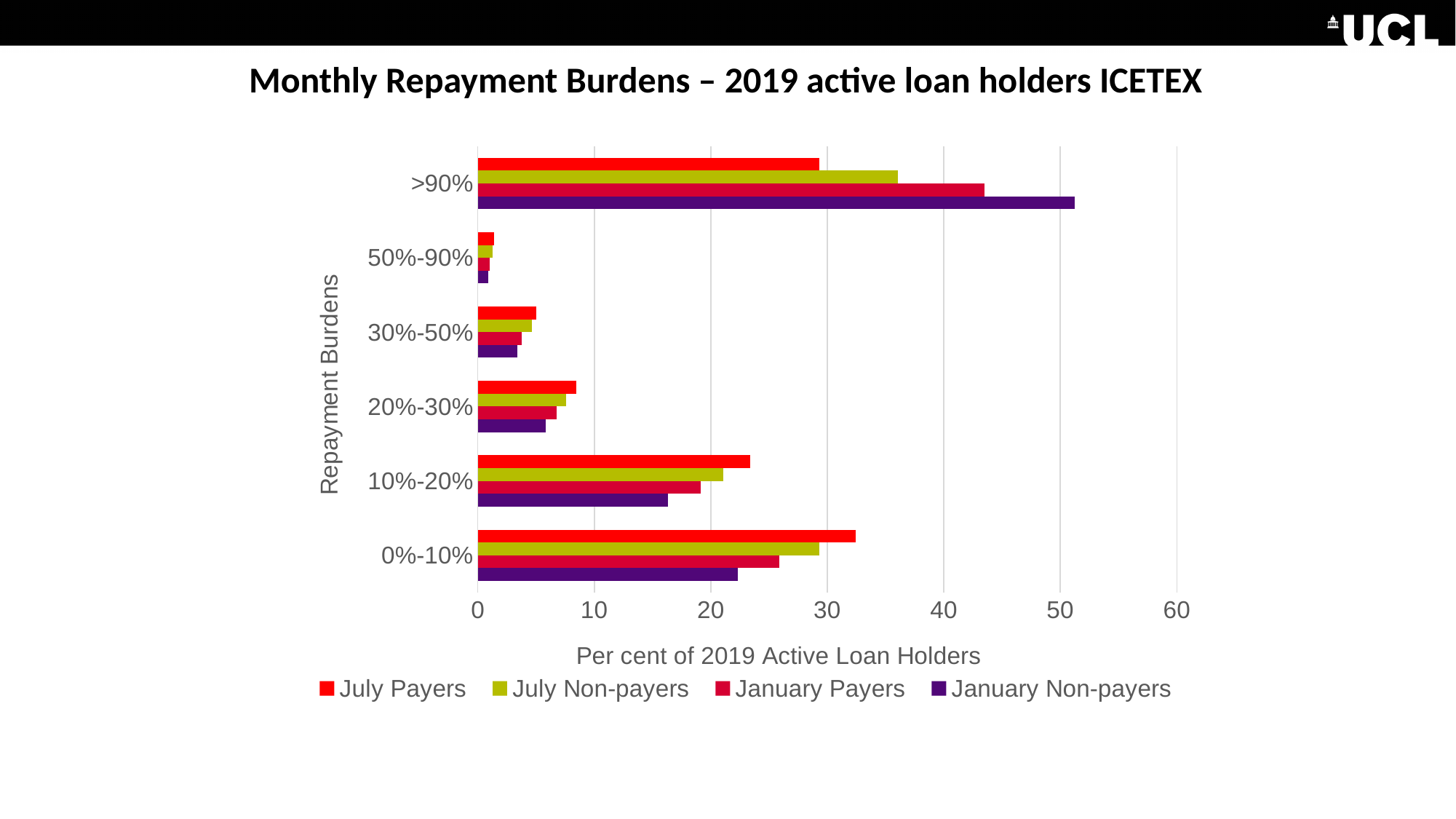
Which repayment burden category has the highest value for January Non-payers? >90% How many repayment burden categories are shown on the y axis? 6 What kind of chart is shown on the slide? Bar chart Is the value for July Payers in the 0%-10% category greater or less than 30? greater What colour represents January Non-payers in the chart? Purple In the >90% category, which is larger: January Payers or July Payers? January Payers How many series does the legend list? 4 Which repayment burden category has the lowest value for July Payers? 50%-90% Is the value for January Non-payers in the 10%-20% category greater or less than 20? less Is the value for January Non-payers in the >90% category greater or less than 50? greater What is the title of the x axis? Per cent of 2019 Active Loan Holders In the 0%-10% category, which is larger: July Payers or January Non-payers? July Payers